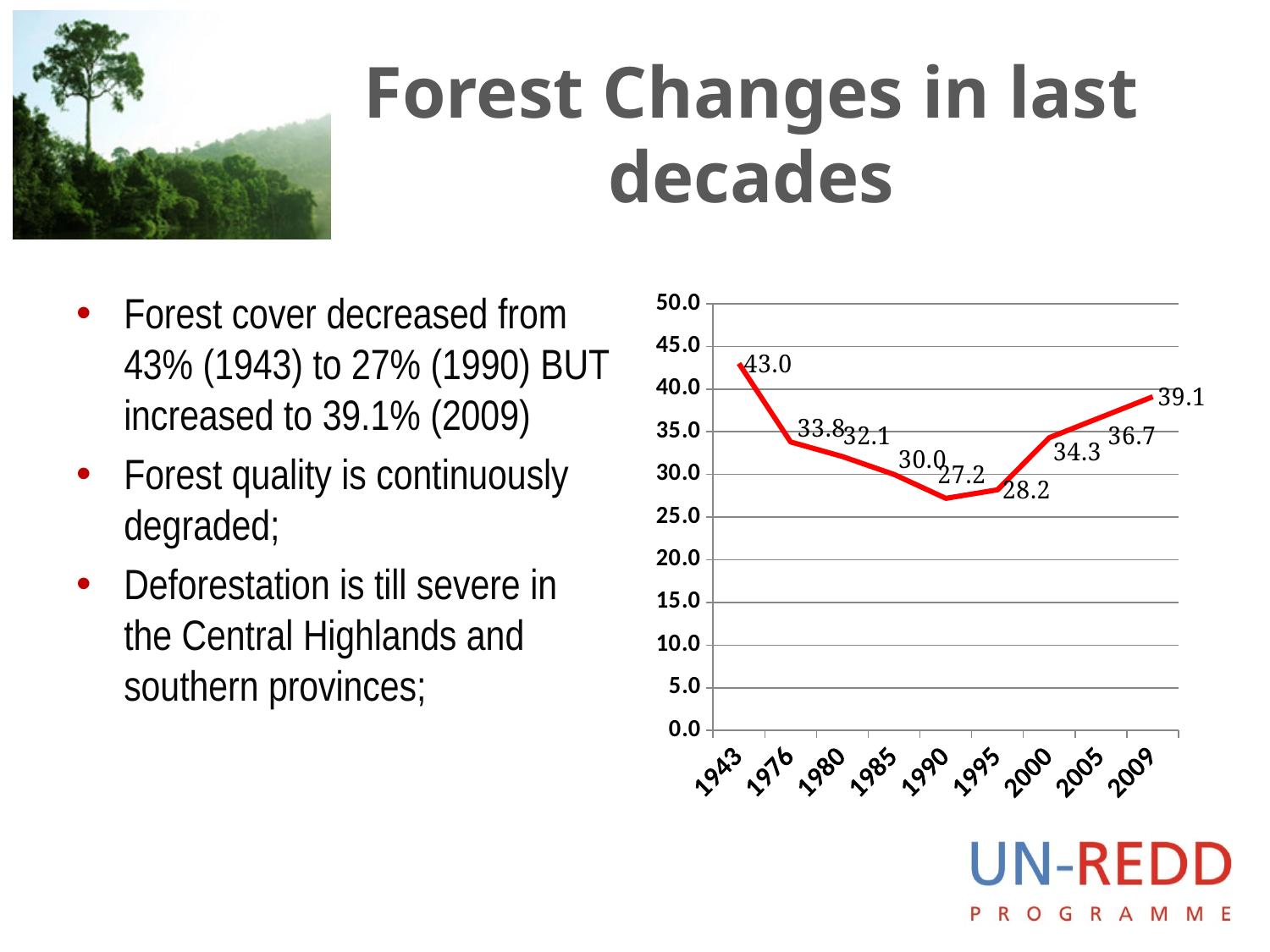
What is the value plotted for 1943? 43.0 What is the difference between the values for 2009 and 1990? 11.9 Which year has the lowest value on the chart? 1990 What is the value plotted for 2009? 39.1 Which is larger, the value for 1976 or the value for 2005? 2005 What is the value plotted for 1990? 27.2 How many years are plotted on the x axis? 9 Which year has the highest value on the chart? 1943 What type of chart is shown on the slide? line chart What is the difference between the values for 1943 and 1990? 15.8 Does the line rise or fall between 1943 and 1990? fall What is the value plotted for 2000? 34.3